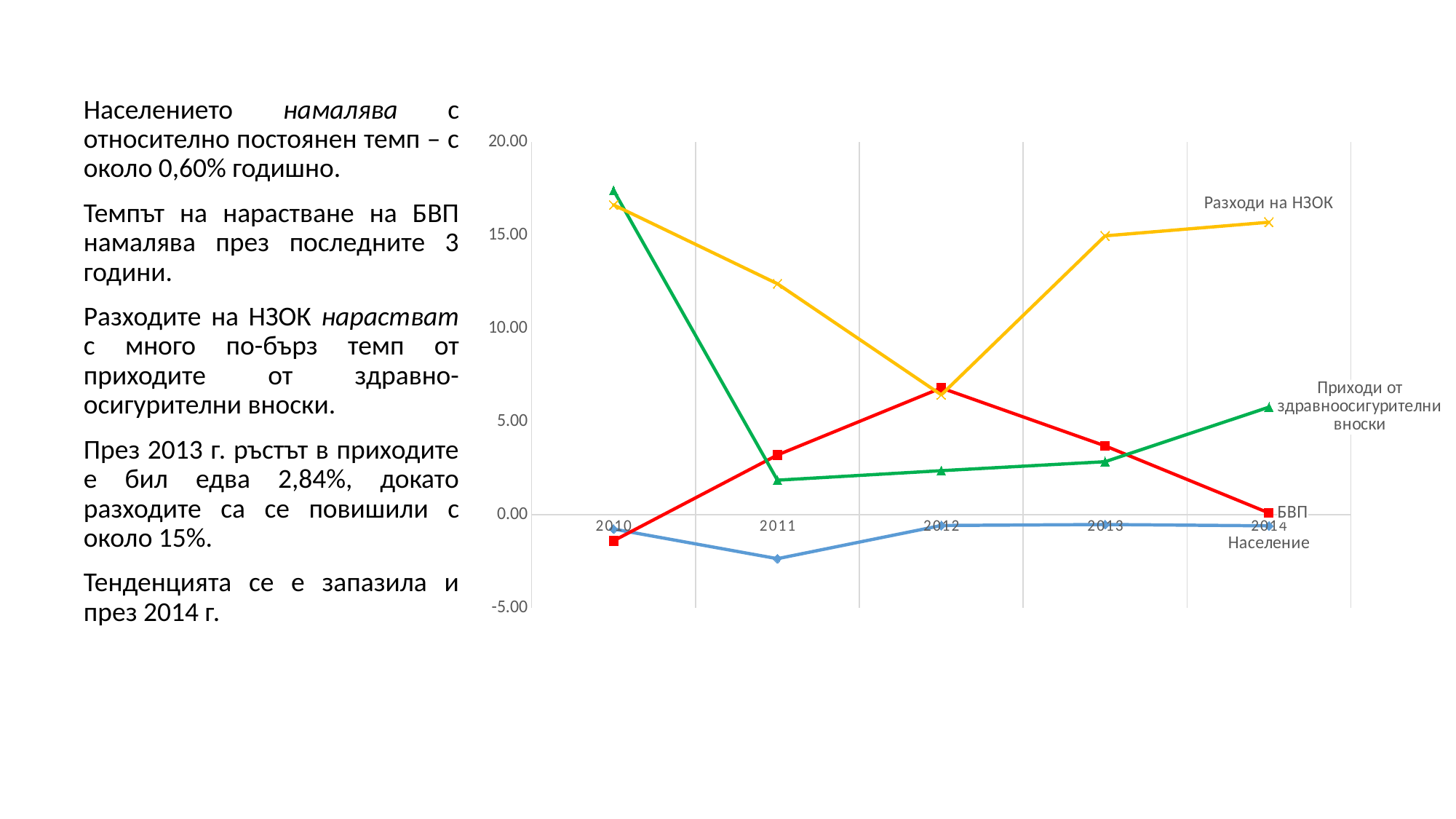
Is the value for Население in 2011 greater or less than 0? less Does the value for Разходи на НЗОК rise or fall from 2012 to 2014? rise Is the value for Разходи на НЗОК in 2010 greater or less than 15? greater In which year is the value for Разходи на НЗОК lowest? 2012 How many years are plotted along the x axis of the chart? 5 What kind of chart is shown on the slide? line chart Is the value for Приходи от здравноосигурителни вноски in 2011 greater or less than 5? less In which year is the value for БВП highest? 2012 How many series are plotted in the chart? 4 In which year is the value for Приходи от здравноосигурителни вноски highest? 2010 In 2013, which is larger: Разходи на НЗОК or БВП? Разходи на НЗОК